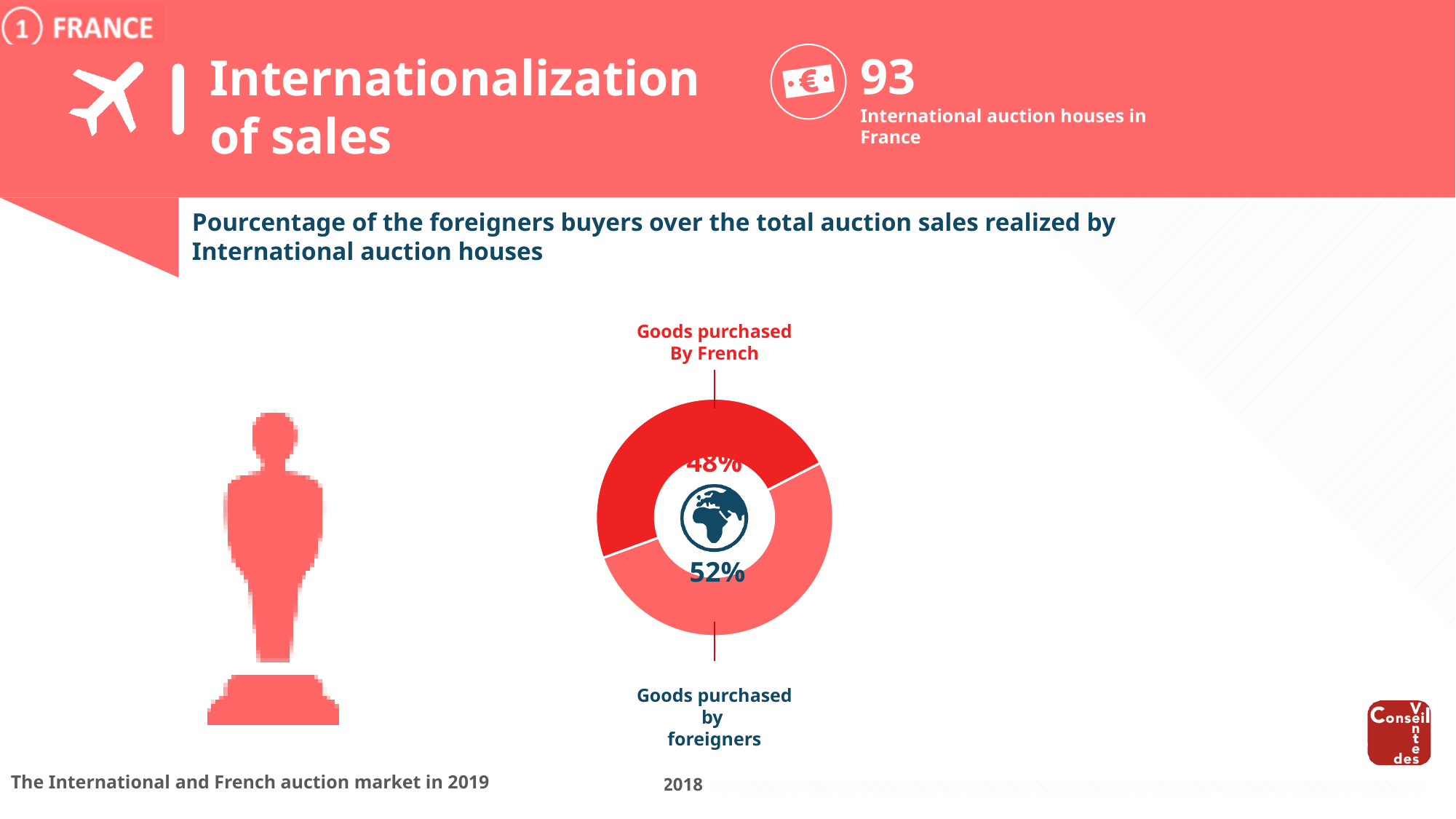
How many categories does the chart show? 2 What year does the chart refer to, according to the label below it? 2018 Is the share for goods purchased by foreigners larger or smaller than the share for goods purchased by French? larger What is the chart's subtitle describing the data shown? Pourcentage of the foreigners buyers over the total auction sales realized by International auction houses Is the share for goods purchased by French greater or less than 50%? less Which category has the smaller share of the chart? Goods purchased by French Which category has the larger share: goods purchased by French or goods purchased by foreigners? Goods purchased by foreigners What kind of chart is shown on the slide? Pie chart (doughnut) What share of goods was purchased by French buyers? 48% What is the difference in percentage points between goods purchased by foreigners and goods purchased by French? 4 percentage points What share of goods was purchased by foreigners? 52%